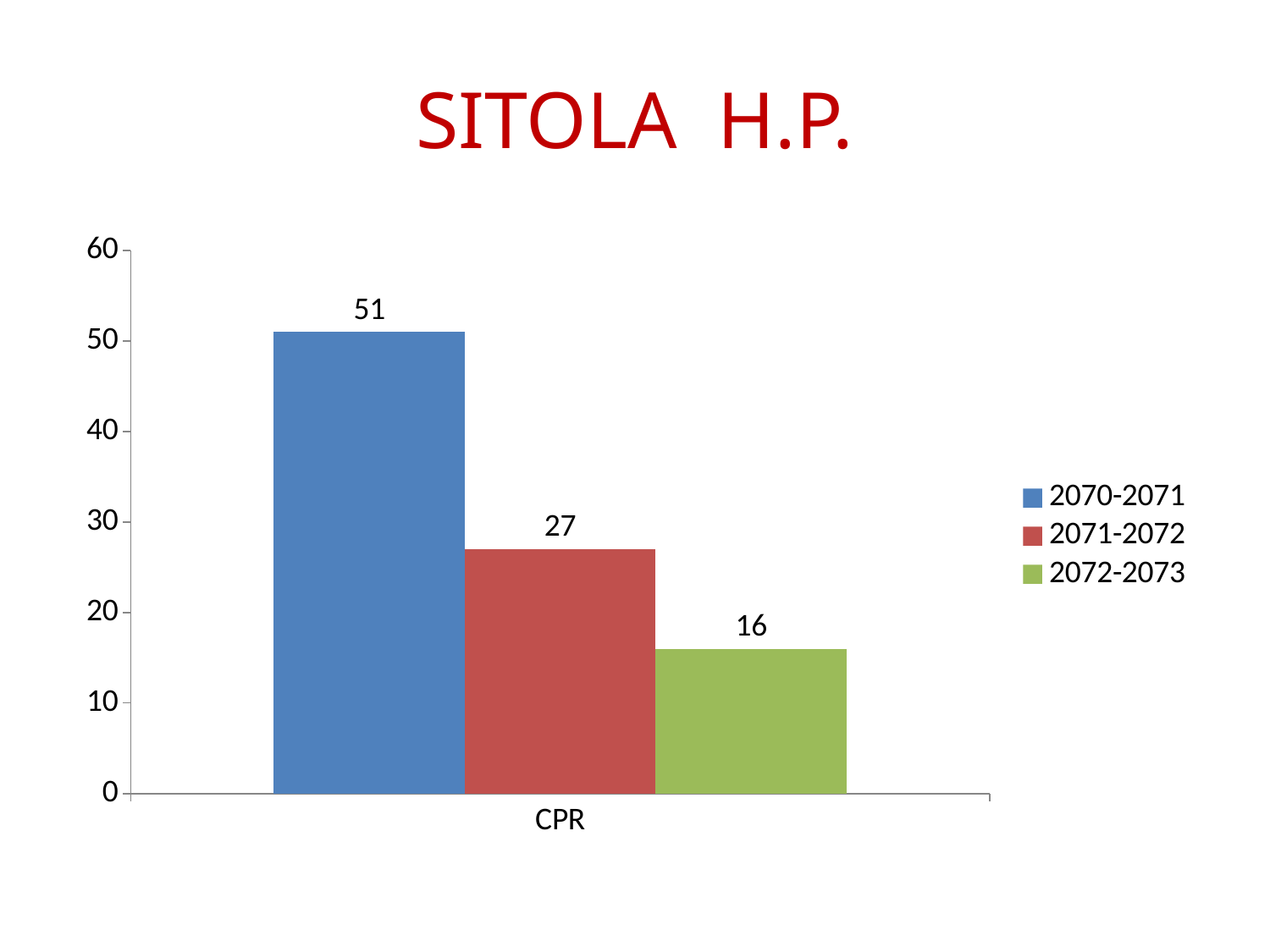
Is the CPR value for 2070-2071 greater or less than 40? greater How many series does the legend list? 3 What is the difference between the CPR values for 2070-2071 and 2071-2072? 24 What is the CPR value for 2071-2072? 27 What is the title of the slide? SITOLA H.P. Which series has the lowest CPR value? 2072-2073 What is the CPR value for 2072-2073? 16 What kind of chart is shown on the slide? bar chart What is the CPR value for 2070-2071? 51 Which series has the highest CPR value? 2070-2071 What is the difference between the CPR values for 2071-2072 and 2072-2073? 11 Which is larger, the CPR value for 2071-2072 or for 2072-2073? 2071-2072